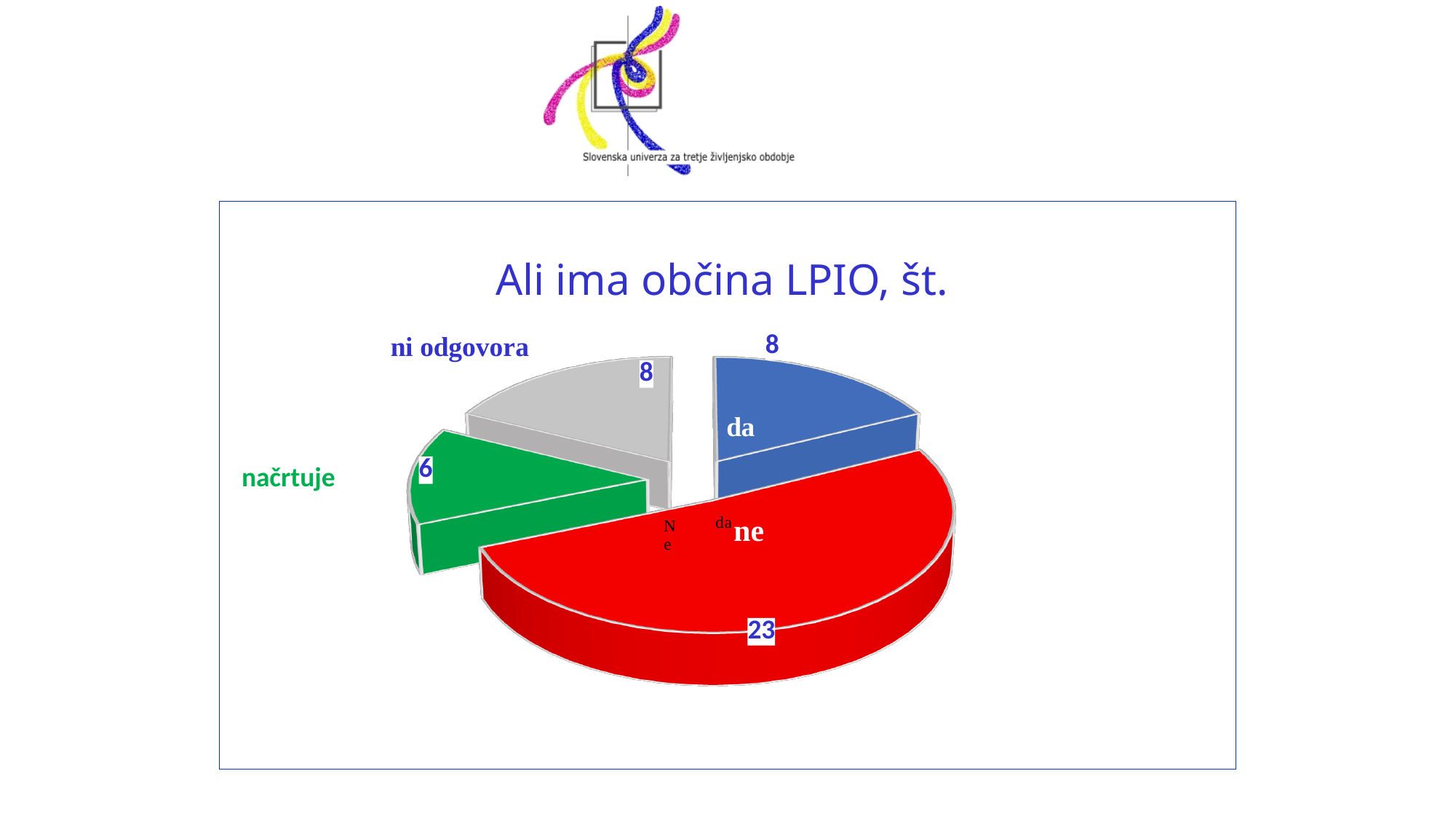
What is the value for the 'ne' slice? 23 What is the difference between the values for 'ne' and 'načrtuje'? 17 Which is larger, the value for 'da' or the value for 'načrtuje'? da What is the total of all the slice values in the pie chart? 45 What is the difference between the values for 'ne' and 'da'? 15 What kind of chart is shown on the slide? pie chart What is the value for the 'ni odgovora' slice? 8 What is the value for the 'da' slice? 8 How many slices does the pie chart have? 4 What is the value for the 'načrtuje' slice? 6 Which category has the smallest slice of the pie? načrtuje Which category has the largest slice of the pie? ne